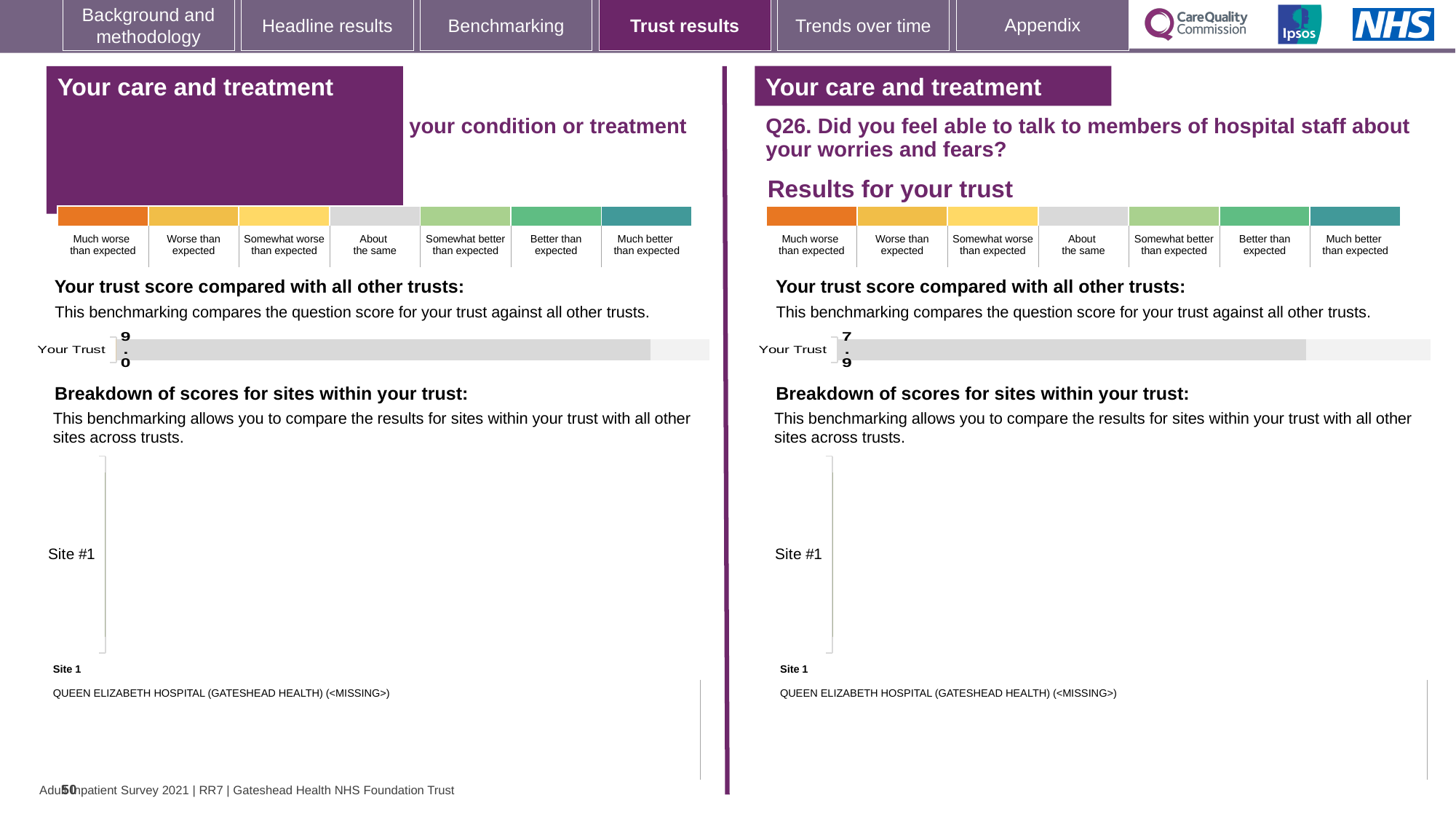
Which question number is the right-hand panel's chart about? Q26 What is the name of Site 1 listed under the right-hand site breakdown chart? QUEEN ELIZABETH HOSPITAL (GATESHEAD HEALTH) (<MISSING>) On the left-hand chart, what is the score shown for Your Trust? 9.0 What is the difference between the Your Trust score on the left-hand chart and the Your Trust score on the right-hand chart (Q26)? 1.1 How many bars are plotted in the 'Your trust score compared with all other trusts' chart on the right-hand panel? 1 How many rating categories does the colour scale above the right-hand chart show? 7 How many sites are listed in the 'Breakdown of scores for sites within your trust' chart on the left-hand panel? 1 Which panel shows the higher Your Trust score, the left-hand chart or the right-hand chart (Q26)? the left-hand chart On the right-hand chart (Q26), what is the score shown for Your Trust? 7.9 What kind of chart is used to show the Your Trust score on the right-hand panel? bar chart